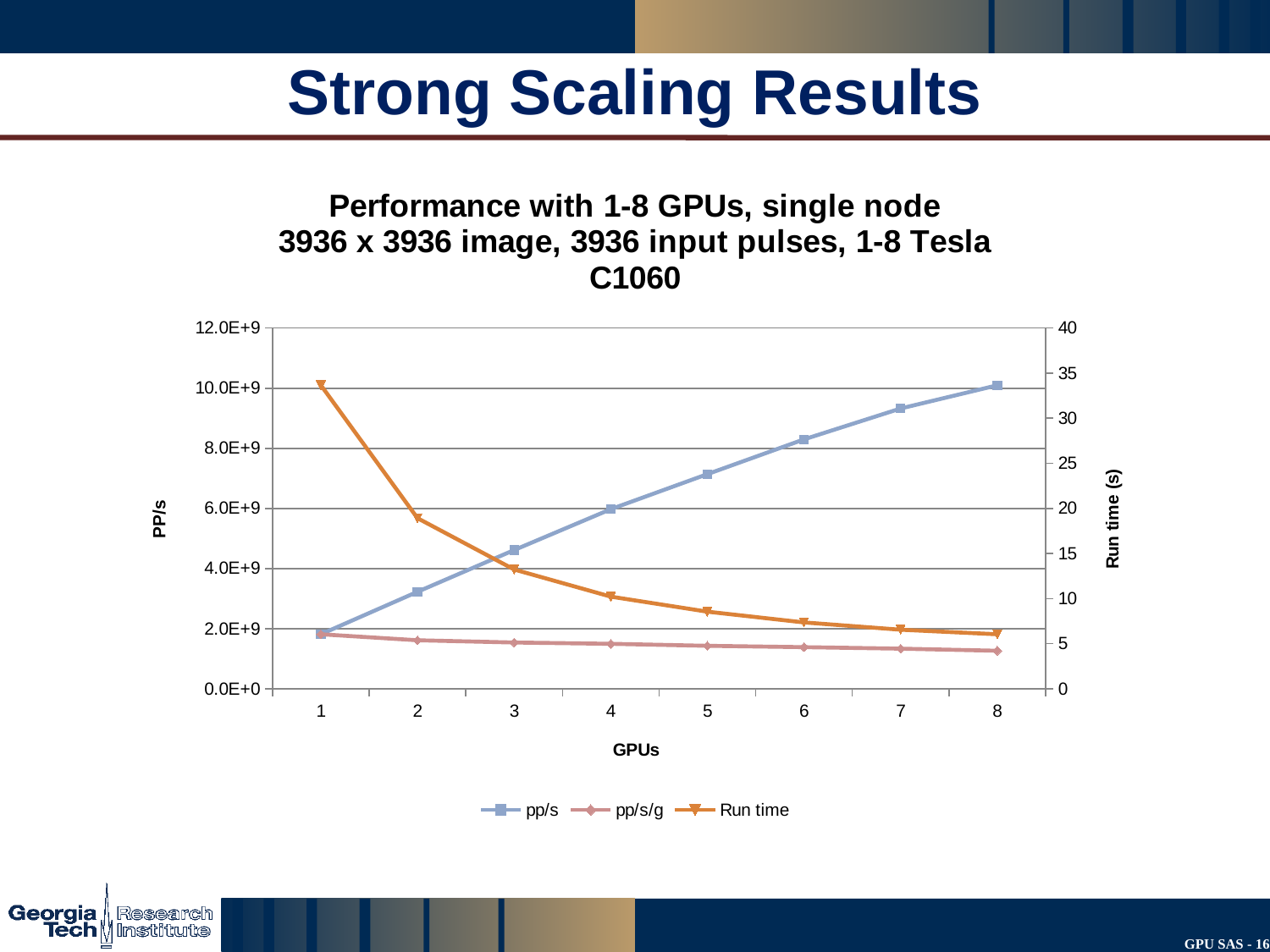
Is the pp/s value at 8 GPUs greater or less than 8.0E+9? greater Is the Run time at 1 GPU greater or less than 30 seconds? greater Is the Run time at 8 GPUs greater or less than 10 seconds? less What is the label of the right-hand vertical axis? Run time (s) Which is larger, the pp/s value at 4 GPUs or at 2 GPUs? 4 GPUs At which number of GPUs is the pp/s value highest? 8 How many series does the legend list? 3 At which number of GPUs is the Run time lowest? 8 What kind of chart is shown on the slide? line chart How many GPU counts are plotted along the x axis? 8 Does the pp/s series rise or fall as the number of GPUs increases? rises Does the Run time series rise or fall as the number of GPUs increases? falls